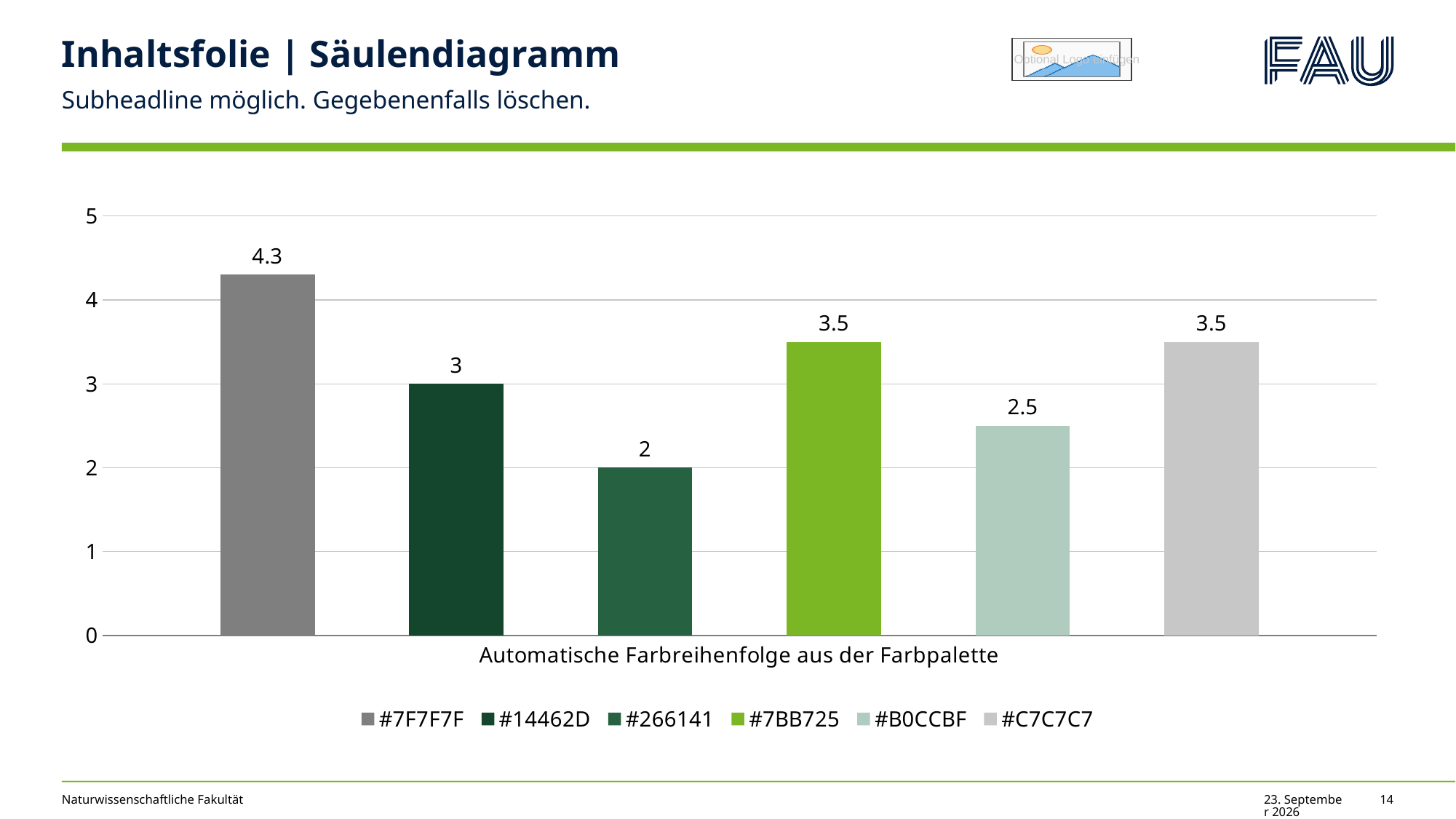
What is the category label shown on the x axis? Automatische Farbreihenfolge aus der Farbpalette What kind of chart is shown on the slide? Bar chart How many series does the legend list? 6 Which is larger, the value of #14462D or the value of #B0CCBF? #14462D What is the difference between the values of #7F7F7F and #266141? 2.3 Which series has the lowest value? #266141 Is the value for #C7C7C7 greater or less than 3? greater What is the value of the #7F7F7F series? 4.3 What is the value of the #7BB725 series? 3.5 What is the value of the #B0CCBF series? 2.5 What is the value of the #14462D series? 3 Which series has the highest value? #7F7F7F